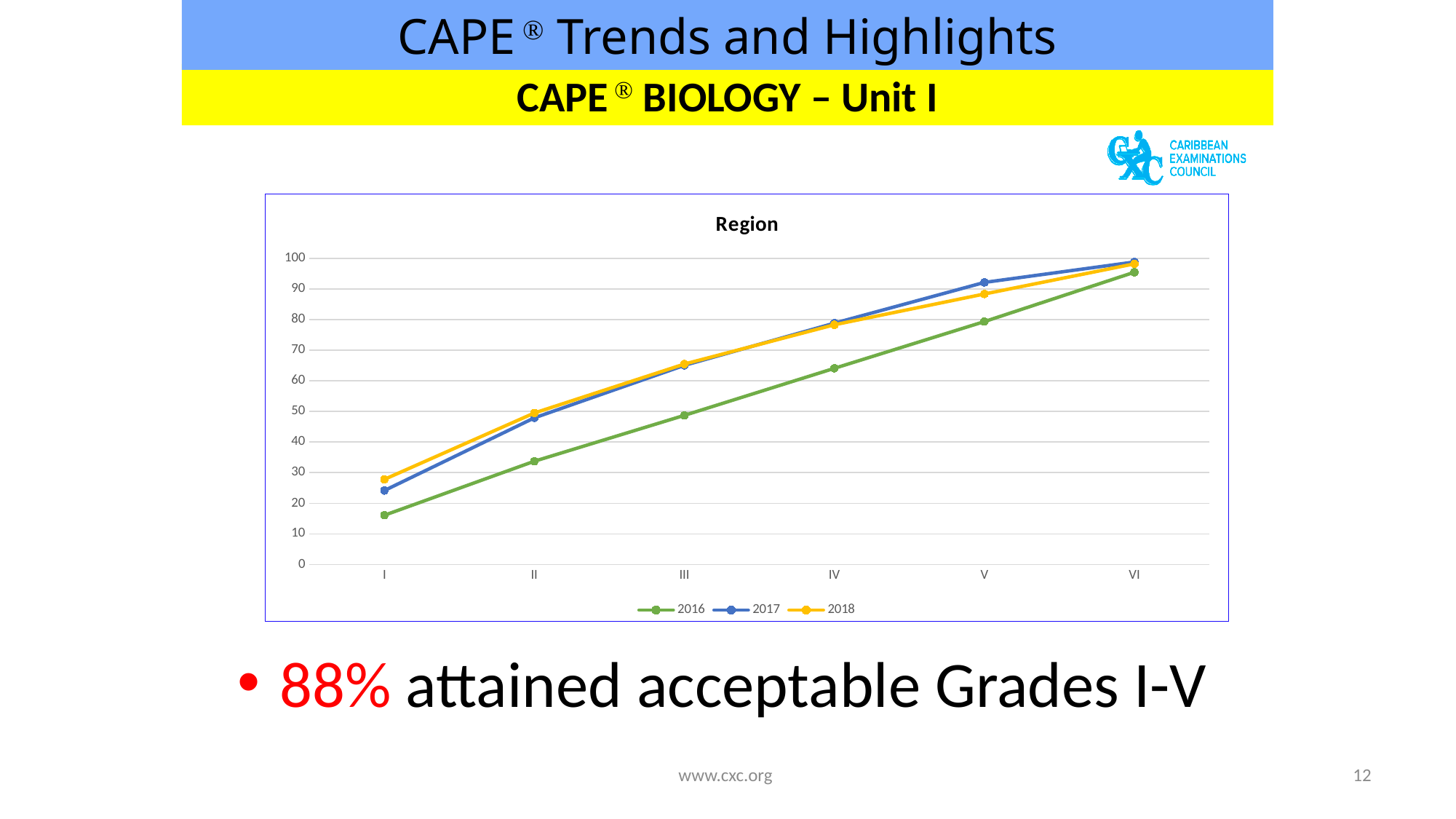
Is the value for 2016 at grade IV greater or less than 60? greater Is the value for 2017 at grade V greater or less than 90? greater Is the value for 2016 at grade I greater or less than 20? less How many series does the legend list? 3 At grade V, which series has the larger value, 2016 or 2017? 2017 How many grade categories are shown on the x axis? 6 What kind of chart is shown on the slide? line chart Which series has the lowest value at grade V? 2016 What is the title of the chart? Region Do the values for the 2016 series rise or fall from grade I to grade VI? rise Which series has the highest value at grade I? 2018